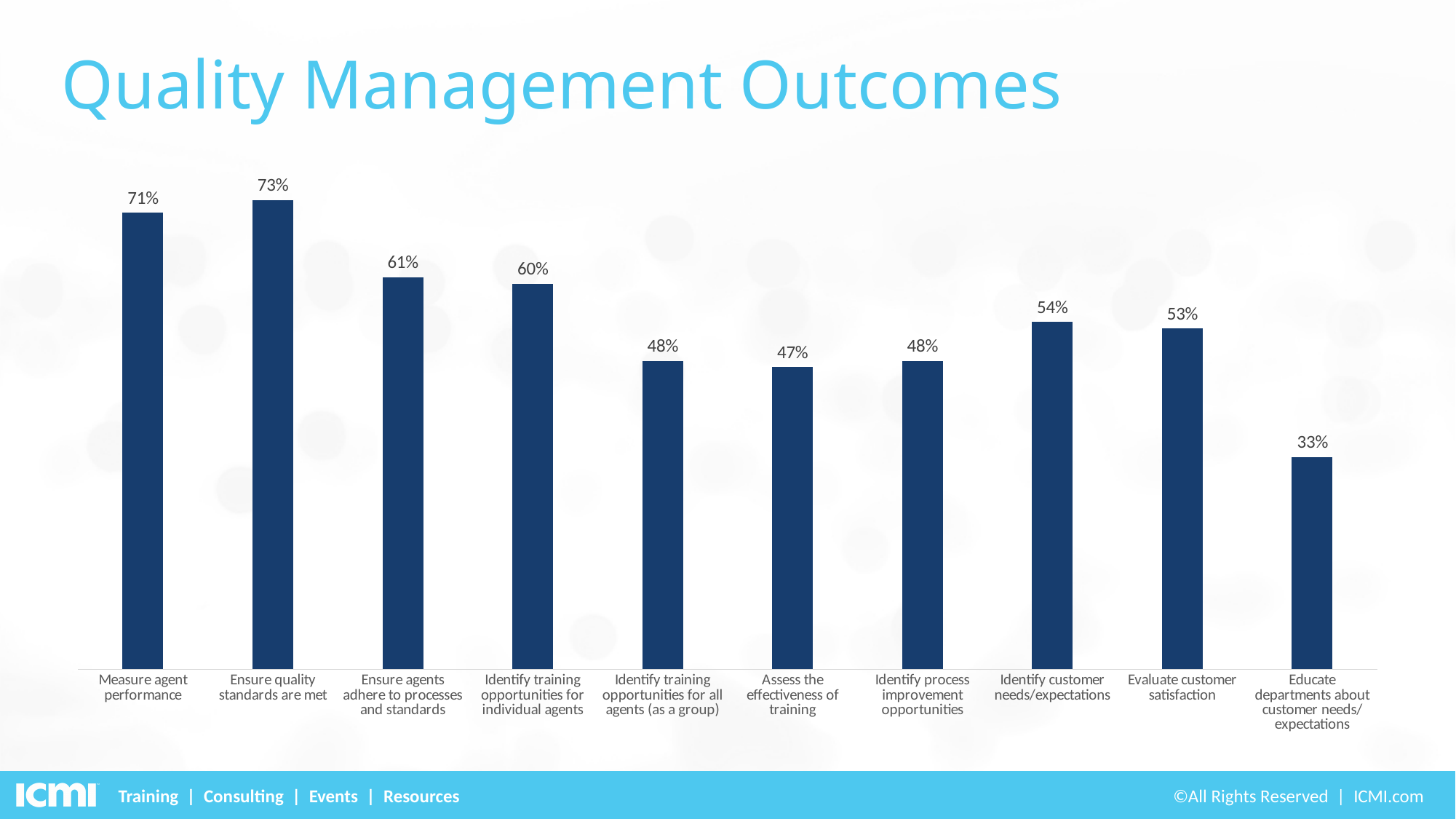
What is the value for "Measure agent performance"? 71% What is the difference between "Ensure quality standards are met" and "Measure agent performance"? 2% What kind of chart is shown on the slide? Bar chart What is the value for "Identify process improvement opportunities"? 48% What is the title of the slide? Quality Management Outcomes Which is larger: "Ensure agents adhere to processes and standards" or "Evaluate customer satisfaction"? Ensure agents adhere to processes and standards What is the difference between "Identify customer needs/expectations" and "Educate departments about customer needs/expectations"? 21% What is the value for "Assess the effectiveness of training"? 47% Which category has the highest value? Ensure quality standards are met What is the value for "Educate departments about customer needs/expectations"? 33% Which category has the lowest value? Educate departments about customer needs/expectations How many categories are shown in the chart? 10